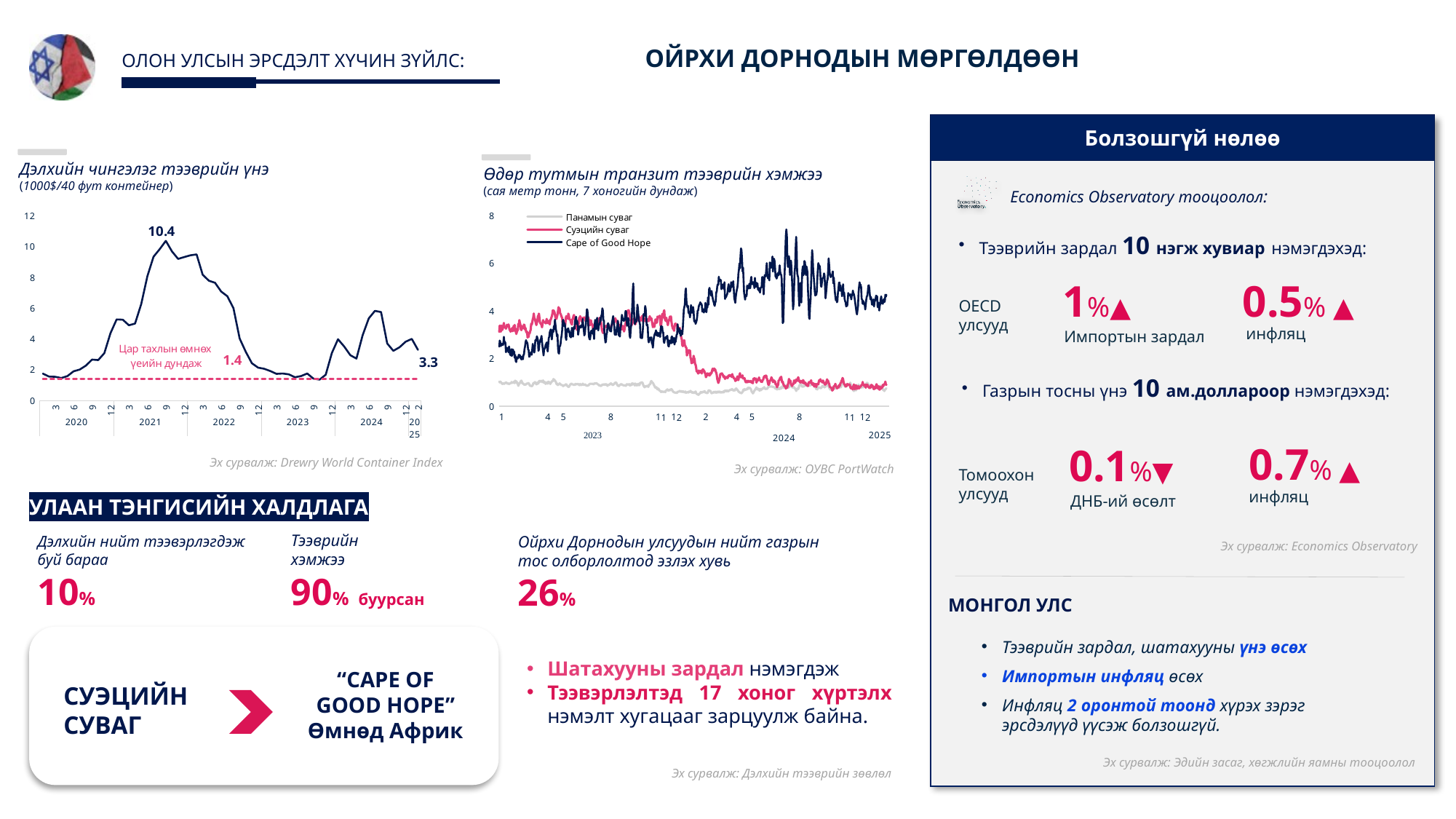
On the chart titled "Дэлхийн чингэлэг тээврийн үнэ", does the line rise or fall between its 2021 peak and the end of 2022? fall On the chart titled "Өдөр тутмын транзит тээврийн хэмжээ", how many series does the legend list? 3 On the chart titled "Дэлхийн чингэлэг тээврийн үнэ", is the final value 3.3 greater or less than the pre-pandemic average 1.4? greater What kind of chart is the one titled "Дэлхийн чингэлэг тээврийн үнэ"? line chart On the chart titled "Өдөр тутмын транзит тээврийн хэмжээ", is the value for Панамын суваг at the end of 2024 greater or less than 2? less On the chart titled "Дэлхийн чингэлэг тээврийн үнэ", what is the peak value labelled on the line? 10.4 On the chart titled "Өдөр тутмын транзит тээврийн хэмжээ", does the Суэцийн суваг line rise or fall from 2023 to 2024? fall On the chart titled "Дэлхийн чингэлэг тээврийн үнэ", what is the difference between the peak value 10.4 and the final value 3.3? 7.1 On the chart titled "Өдөр тутмын транзит тээврийн хэмжээ", what are the three legend entries? Панамын суваг, Суэцийн суваг, Cape of Good Hope On the chart titled "Дэлхийн чингэлэг тээврийн үнэ", what value is labelled at the end of the line in 2025? 3.3 On the chart titled "Өдөр тутмын транзит тээврийн хэмжээ", which series is higher at the end of 2024: Суэцийн суваг or Cape of Good Hope? Cape of Good Hope On the chart titled "Дэлхийн чингэлэг тээврийн үнэ", what is the value of the pre-pandemic average (Цар тахлын өмнөх үеийн дундаж) dashed line? 1.4